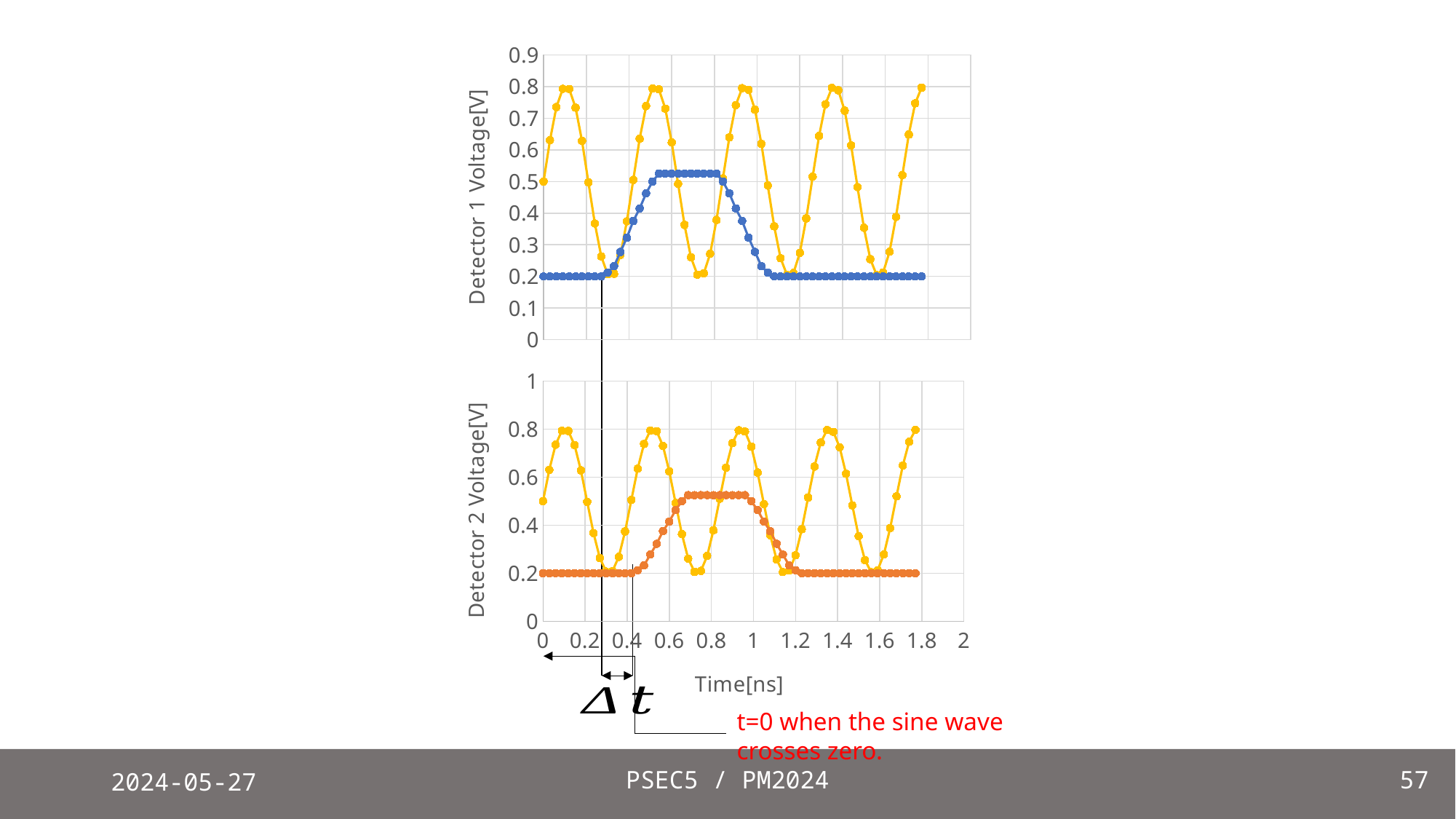
What is the y-axis label of the bottom chart? Detector 2 Voltage[V] In the bottom chart, does the orange line rise or fall between time 0.9 and time 1.2? fall In the bottom chart, what is the value of the orange line at time 0? 0.2 What type of chart is the top chart (Detector 1 Voltage[V])? line chart In the top chart, is the plateau value of the blue line greater or less than 0.4? greater In the top chart, at time 0.8, which line has the higher value, the yellow line or the blue line? blue line In the top chart, is the plateau value of the blue line greater or less than 0.7? less In the top chart, does the blue line rise or fall between time 0.3 and time 0.5? rise In the top chart, what is the value of the blue line at time 0? 0.2 In the bottom chart, is the peak value of the yellow sine wave greater or less than 0.6? greater What is the x-axis label shown below the bottom chart? Time[ns]